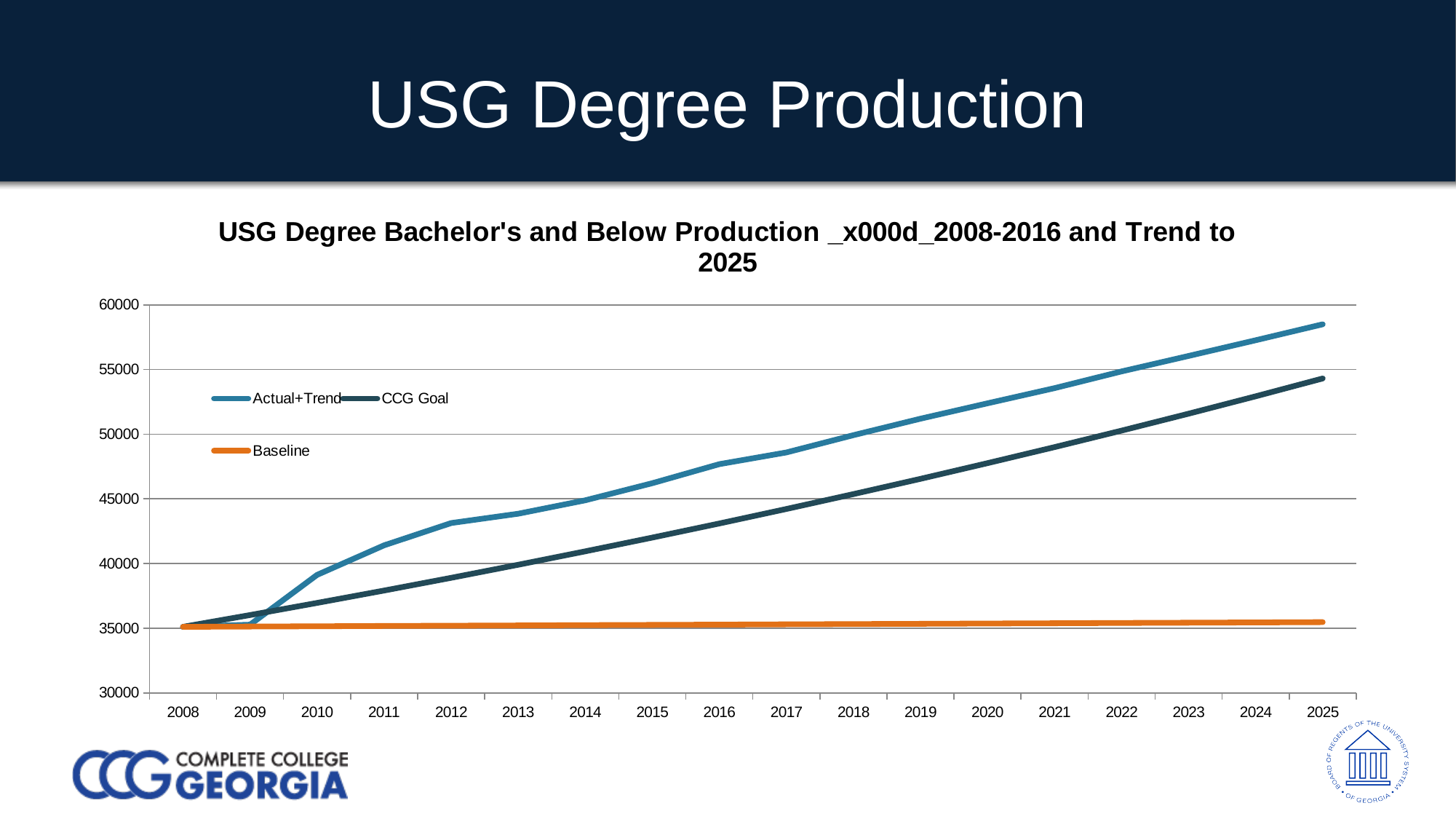
Is the CCG Goal value for 2018 greater or less than 50000? less How many years are shown along the x axis? 18 Is the Actual+Trend value for 2012 greater or less than 40000? greater How many series does the legend list? 3 Does the Actual+Trend series rise or fall from 2008 to 2025? Rise What is the first year shown on the x axis? 2008 What kind of chart is shown on the slide? Line chart Which series is lowest in 2025? Baseline Is the Actual+Trend value for 2025 greater or less than 55000? greater Which series is highest in 2025? Actual+Trend In 2020, which is larger: Actual+Trend or CCG Goal? Actual+Trend